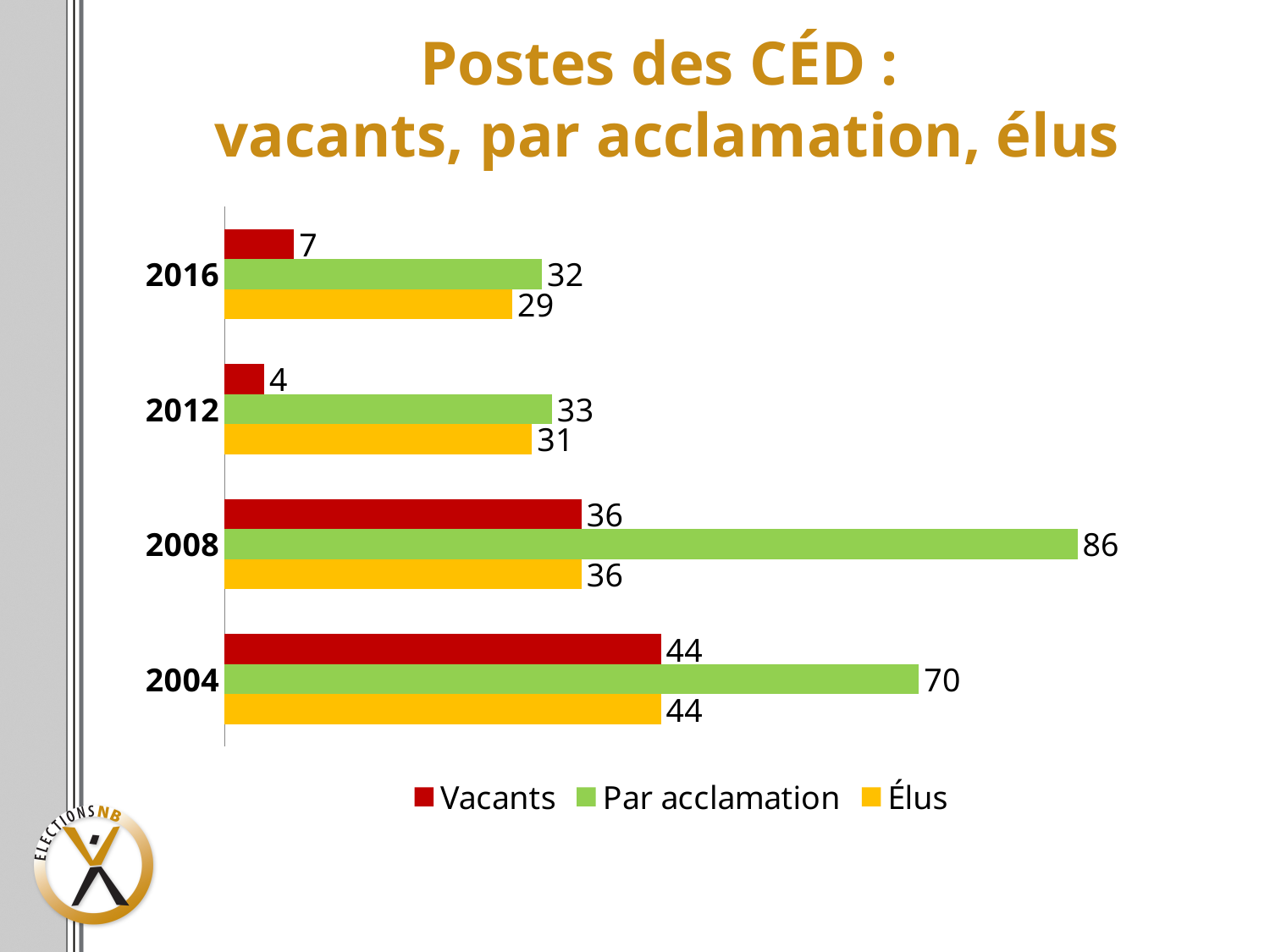
How many years are shown on the chart? 4 What is the value for Élus in 2012? 31 What is the value for Par acclamation in 2008? 86 How many series does the legend list? 3 Which year has the highest value for Par acclamation? 2008 Which is larger, the Élus value for 2016 or the Élus value for 2012? 2012 What is the total of Vacants, Par acclamation and Élus for 2004? 158 What kind of chart is shown on the slide? bar chart Which colour represents the Élus series in the legend? yellow Which year has the lowest value for Vacants? 2012 What is the value for Vacants in 2016? 7 What is the difference between the Par acclamation values for 2008 and 2004? 16